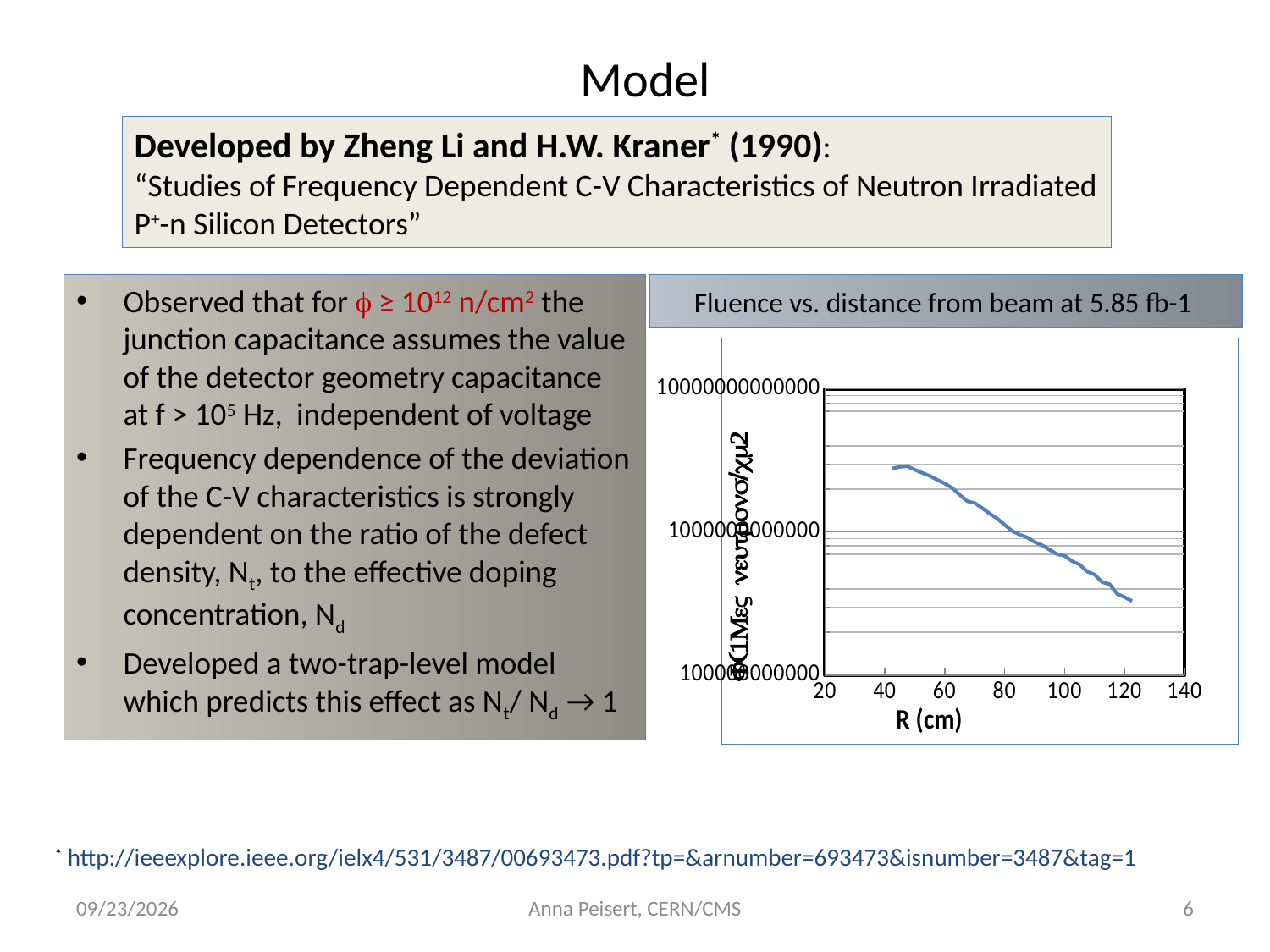
Is the plotted value at R = 50 cm greater or less than 10000000000000? less How many data series are plotted in the chart? 1 Is the plotted value at R = 120 cm greater or less than 1000000000000? less What kind of chart is shown on the slide? line chart Is the plotted value at R = 100 cm greater or less than 1000000000000? less What is the label of the x axis of the chart? R (cm) Does the plotted fluence rise or fall as R increases along the x axis? fall Which has the larger plotted fluence, R = 60 cm or R = 110 cm? R = 60 cm What is the title of the chart on the slide? Fluence vs. distance from beam at 5.85 fb-1